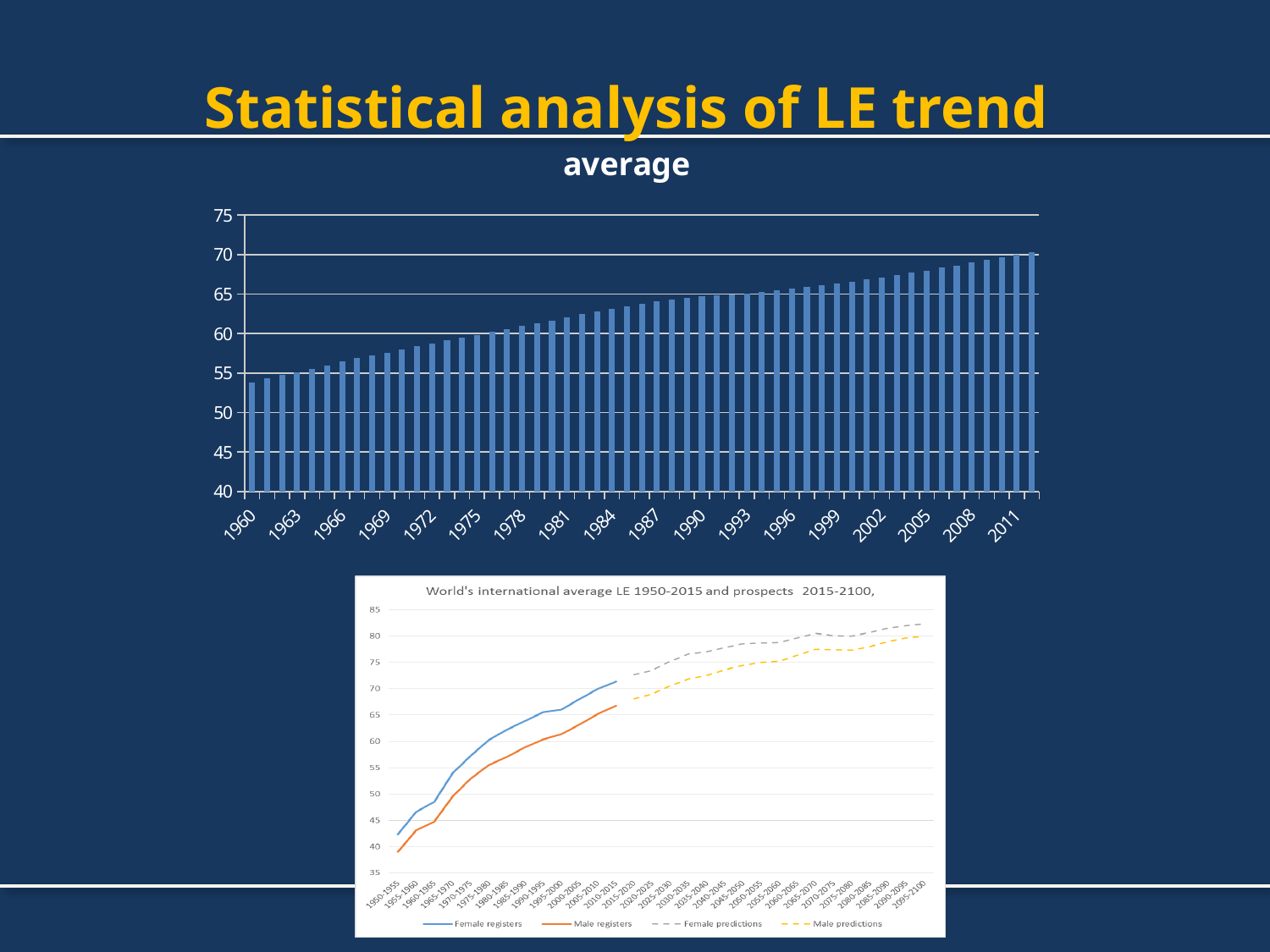
In the top "average" chart, which year has the lowest value? 1960 In the top "average" chart, is the value for 1984 greater or less than 60? greater In the top "average" chart, do the values rise or fall from 1960 to 2011? rise How many series does the legend of the bottom chart list? 4 In the top "average" chart, is the value for 1960 greater or less than 55? less What kind of chart is the top chart titled "average"? bar chart What kind of chart is the bottom chart? line chart In the bottom chart, which series is higher in 2010-2015, Female registers or Male registers? Female registers In the top "average" chart, which is larger, the value for 1960 or the value for 2011? 2011 In the top "average" chart, is the value for 2011 greater or less than 65? greater What is the title of the bottom chart? World's international average LE 1950-2015 and prospects 2015-2100,